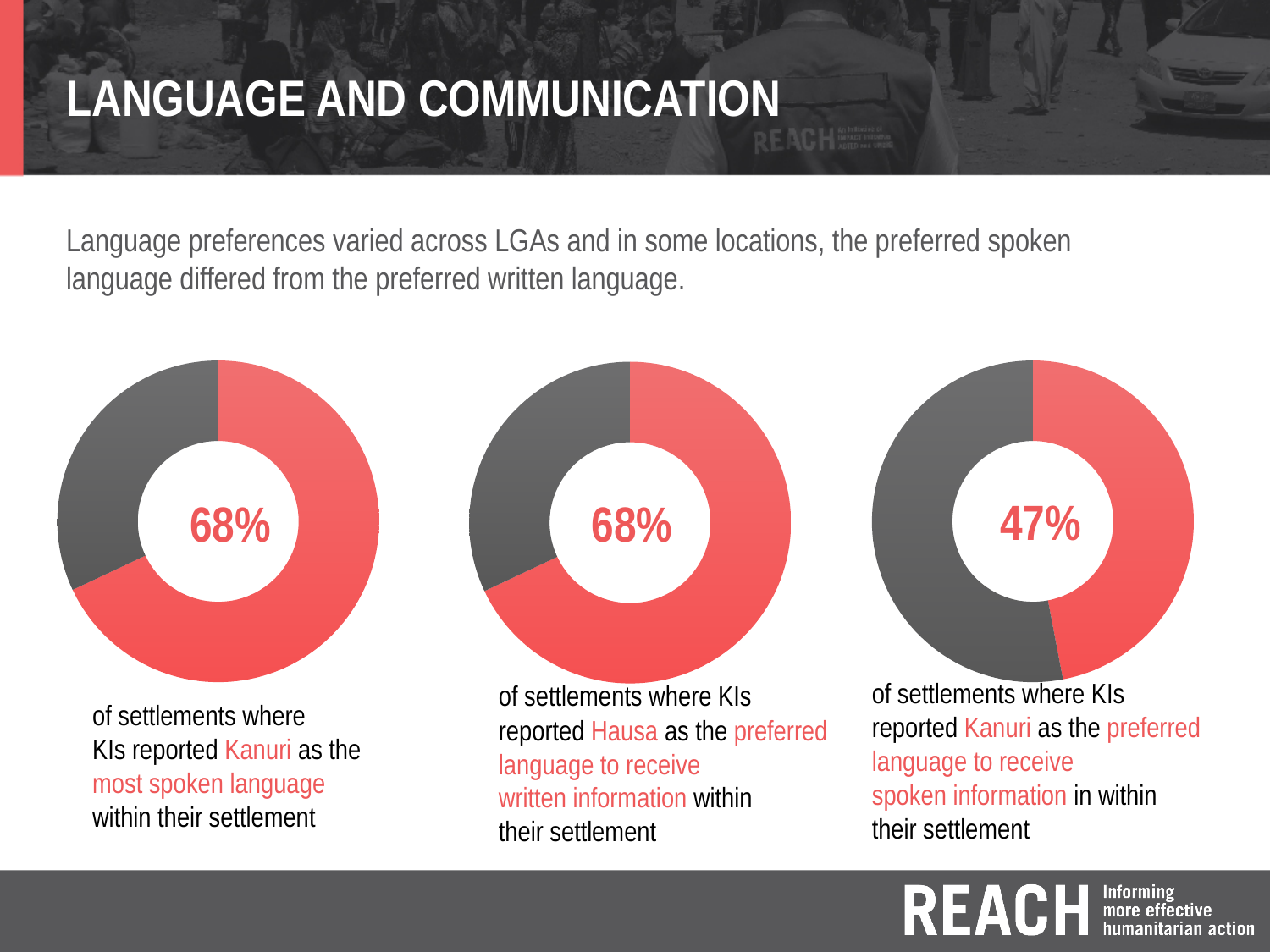
What is the difference between the percentage on the middle donut chart and the percentage on the right donut chart? 21 percentage points What kind of chart is used to show the three percentages on the slide? Donut (pie) chart On the middle donut chart, what percentage of settlements had KIs report Hausa as the preferred language to receive written information? 68% Is the value shown on the right donut chart greater or less than 50%? less On the left donut chart, what percentage of settlements had KIs report Kanuri as the most spoken language within their settlement? 68% On the right donut chart, what percentage of settlements had KIs report Kanuri as the preferred language to receive spoken information? 47% Which of the three donut charts shows the lowest percentage? The right chart (47%) What colour is used for the highlighted segment representing the stated percentage in each donut chart? Red How many donut charts are shown on the slide? 3 On the left donut chart, what share of the ring is not covered by the 68% highlighted segment? 32% Which is larger: the percentage on the left donut chart (Kanuri as most spoken language) or the percentage on the right donut chart (Kanuri as preferred spoken information language)? The left chart (68%) On the right donut chart, what share of the ring is not covered by the 47% highlighted segment? 53%